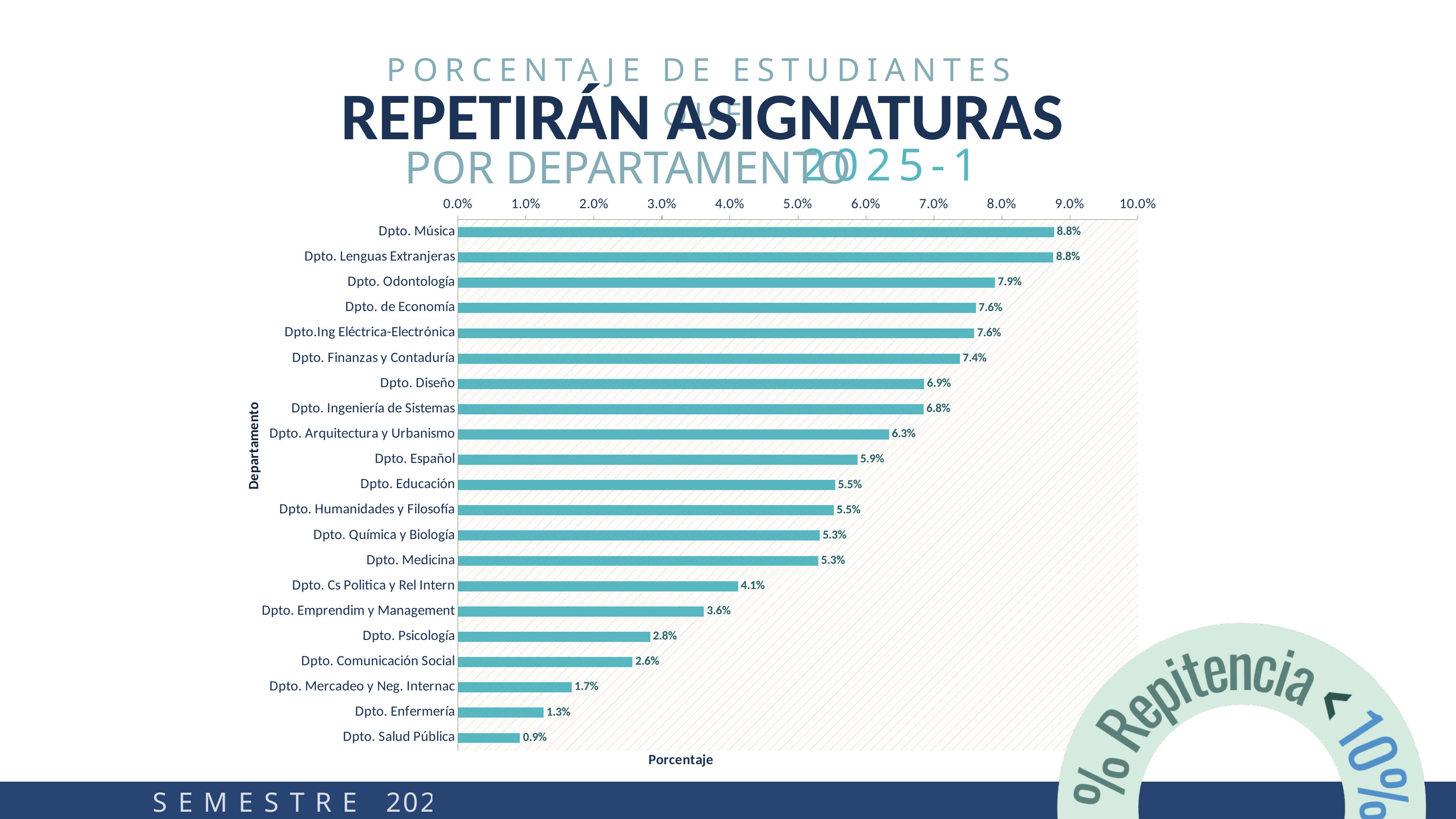
What is the label of the vertical axis? Departamento Which department has the lowest percentage? Dpto. Salud Pública What is the value for Dpto. Odontología? 7.9% What is the difference between the values for Dpto. Música and Dpto. Salud Pública? 7.9% What is the label of the horizontal axis? Porcentaje How many departments are shown in the chart? 21 What is the value for Dpto. Arquitectura y Urbanismo? 6.3% What is the value for Dpto. Psicología? 2.8% What kind of chart is shown on the slide? bar chart Which is larger, the value for Dpto. Medicina or the value for Dpto. Cs Politica y Rel Intern? Dpto. Medicina What is the difference between the values for Dpto. Diseño and Dpto. Español? 1.0% Is the value for Dpto. Finanzas y Contaduría greater or less than 7.0%? greater